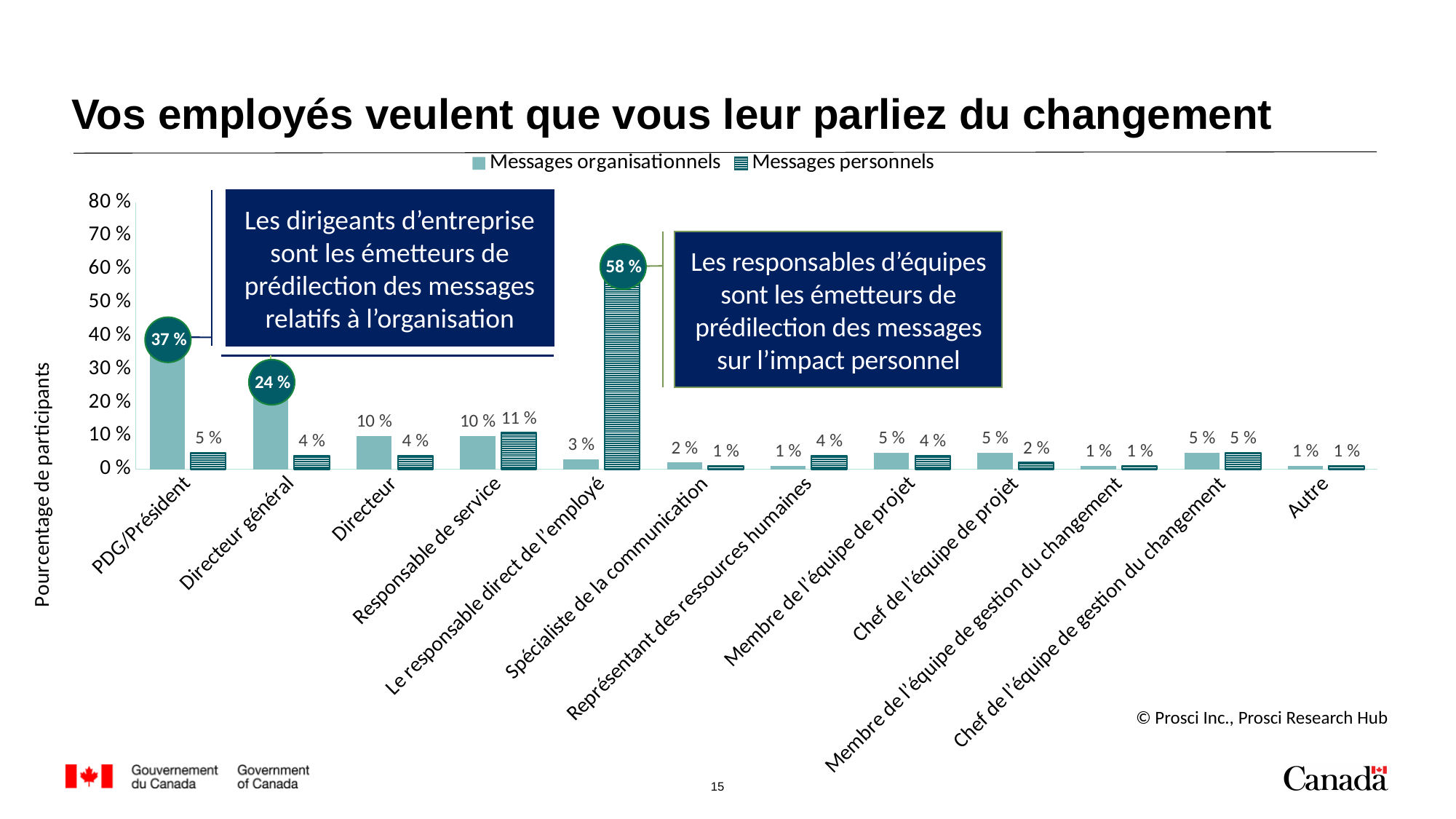
Which category has the highest value for Messages organisationnels? PDG/Président Which category has the highest value for Messages personnels? Le responsable direct de l'employé How many categories are shown on the x axis? 12 For Représentant des ressources humaines, which is larger: Messages organisationnels or Messages personnels? Messages personnels What is the value for Messages personnels for Responsable de service? 11 % What is the value for Messages personnels for Le responsable direct de l'employé? 58 % What is the difference between Messages organisationnels and Messages personnels for PDG/Président? 32 % What is the value for Messages organisationnels for Directeur général? 24 % What is the label of the y axis? Pourcentage de participants What kind of chart is shown on the slide? Bar chart How many series does the legend list? 2 What is the value for Messages organisationnels for PDG/Président? 37 %